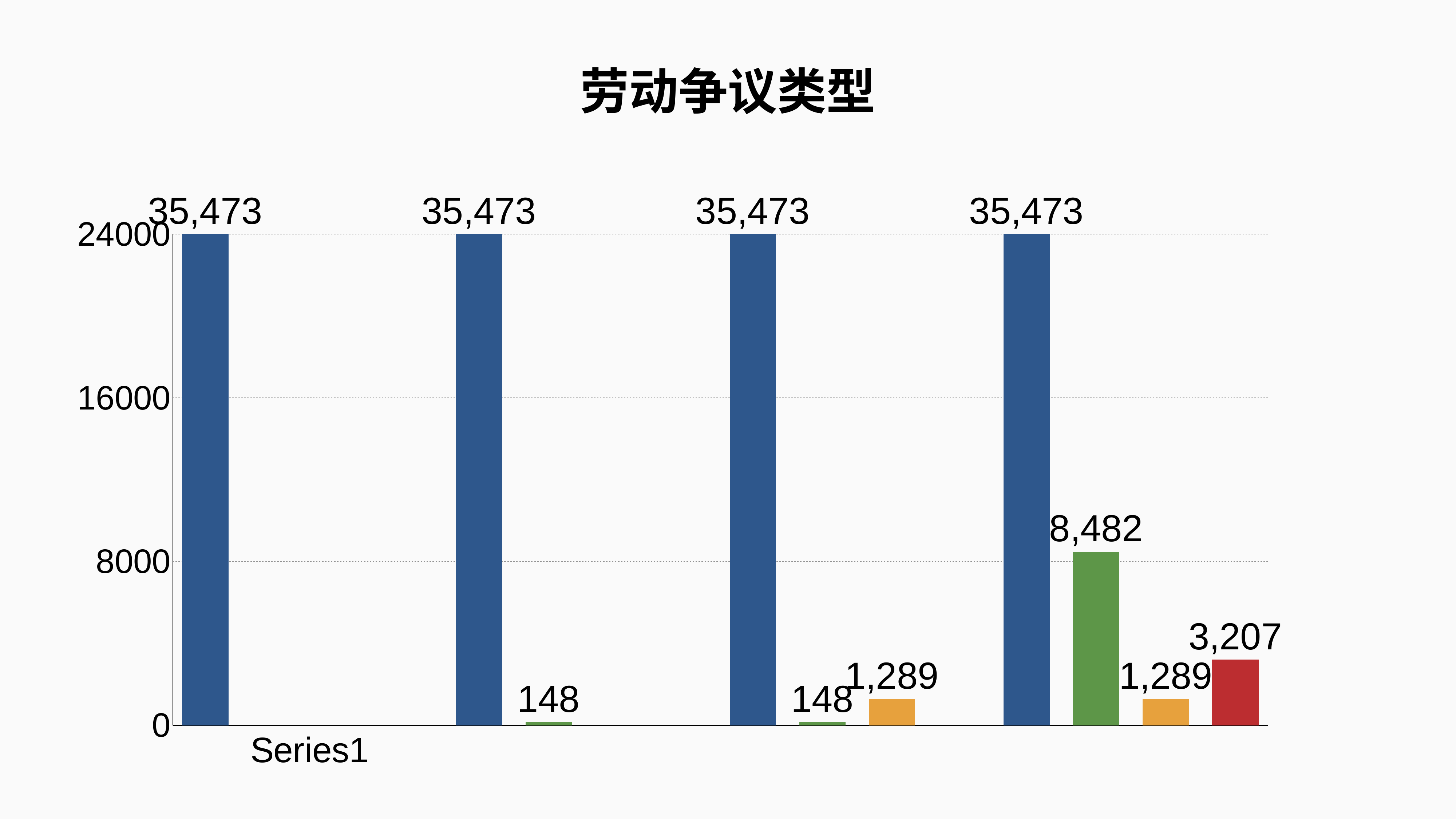
What is the difference between the green bar (8,482) and the red bar (3,207) in the rightmost group? 5,275 What kind of chart is shown on the slide? bar chart What is the value of the red bar in the rightmost group of bars? 3,207 Is the value of the red bar in the rightmost group greater or less than 8000? less How many groups of bars are plotted on the chart? 4 What is the value of the blue bar in the Series1 group? 35,473 What is the highest value labeled on the chart? 35,473 What is the value of the orange bar in the rightmost group of bars? 1,289 What is the lowest value labeled on the chart? 148 What is the title of the chart? 劳动争议类型 What is the value of the green bar in the rightmost group of bars? 8,482 In the rightmost group, which is larger: the green bar or the red bar? the green bar (8,482)